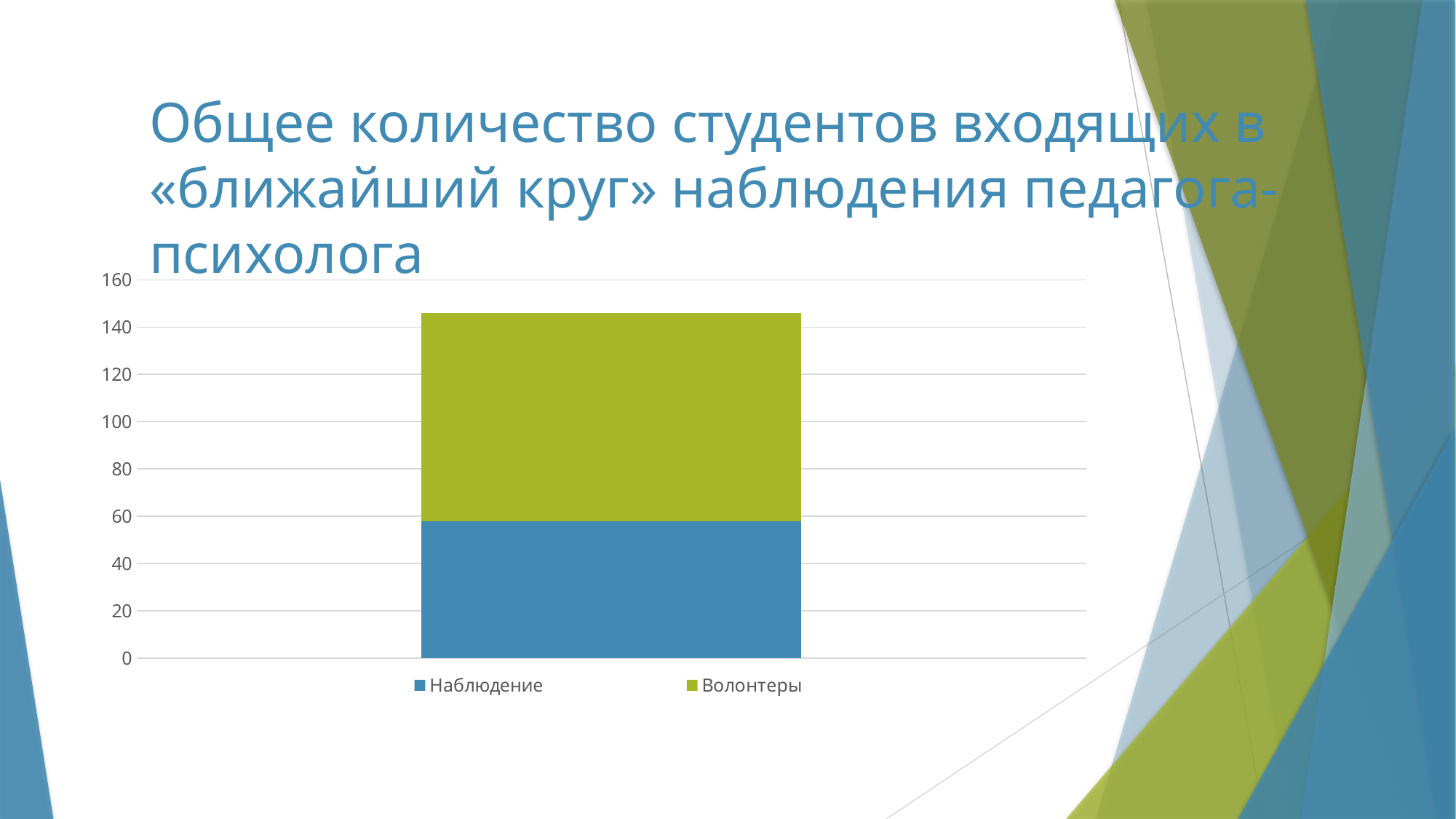
Is the value for Наблюдение greater or less than 40? greater How many bars are plotted in the chart? 1 Which segment of the stacked bar is larger, Наблюдение or Волонтеры? Волонтеры Which series is shown in green in the chart? Волонтеры How many series does the legend list? 2 What kind of chart is shown on the slide? stacked bar chart Which series is shown in blue in the chart? Наблюдение Is the value for Волонтеры greater or less than 60? greater What is the highest value shown on the vertical axis? 160 Is the value for Наблюдение greater or less than 80? less